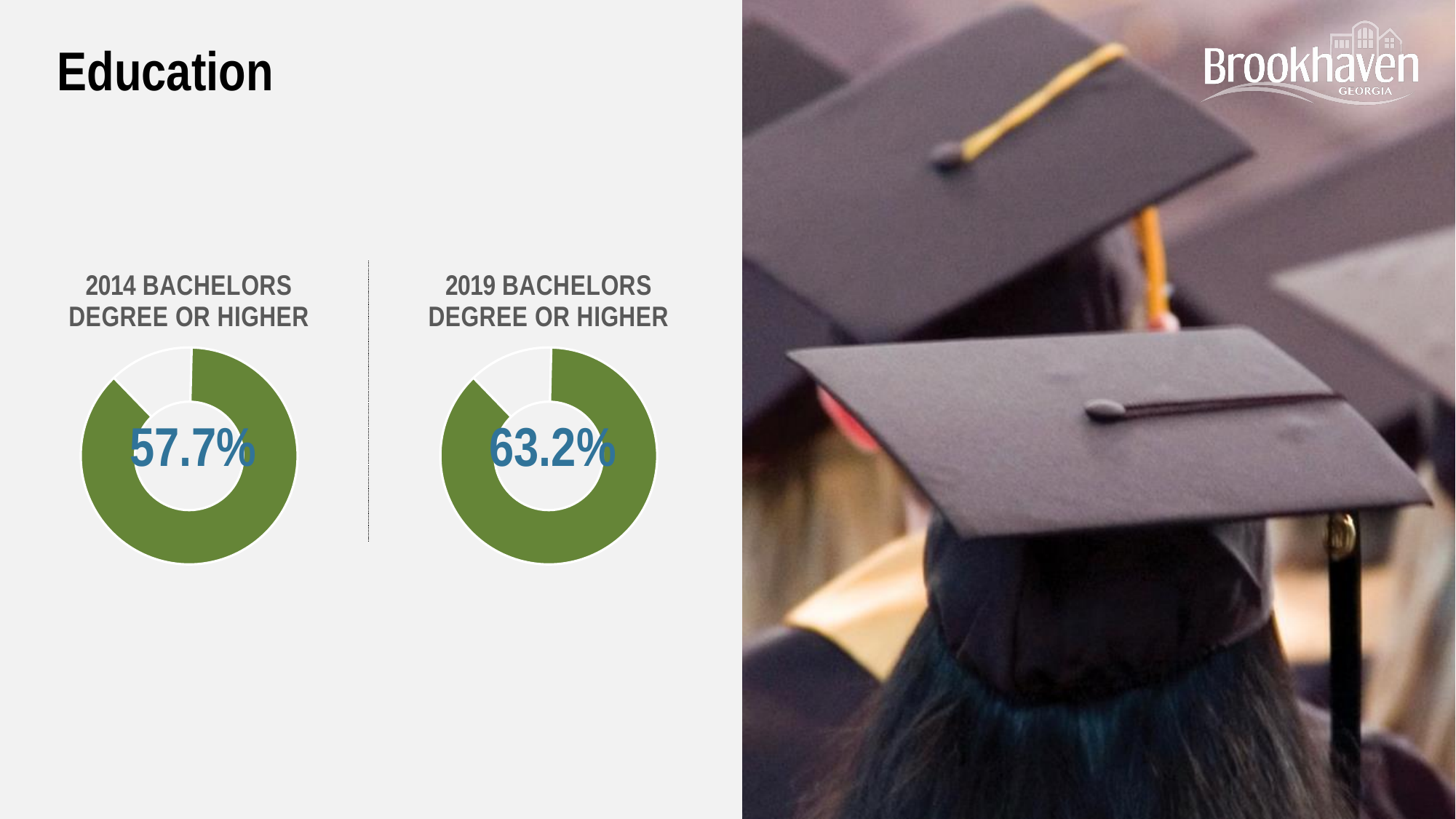
How many donut charts are shown on the slide? 2 On the 2014 Bachelors Degree or Higher chart, what percentage is shown in the centre of the donut? 57.7% What kind of chart is used for the 2014 Bachelors Degree or Higher figure? Donut (pie) chart By how many percentage points does the value on the 2019 Bachelors Degree or Higher chart exceed the value on the 2014 Bachelors Degree or Higher chart? 5.5 percentage points What colour is the filled ring of the 2019 Bachelors Degree or Higher donut chart? Green What is the title of the chart on the left of the slide? 2014 Bachelors Degree or Higher Is the value on the 2014 Bachelors Degree or Higher chart greater or less than 50%? greater Which chart shows the higher percentage, the 2014 Bachelors Degree or Higher chart or the 2019 Bachelors Degree or Higher chart? 2019 Bachelors Degree or Higher On the 2019 Bachelors Degree or Higher chart, what percentage is shown in the centre of the donut? 63.2% Did the share of residents with a bachelors degree or higher rise or fall from 2014 to 2019 according to the two charts? Rise